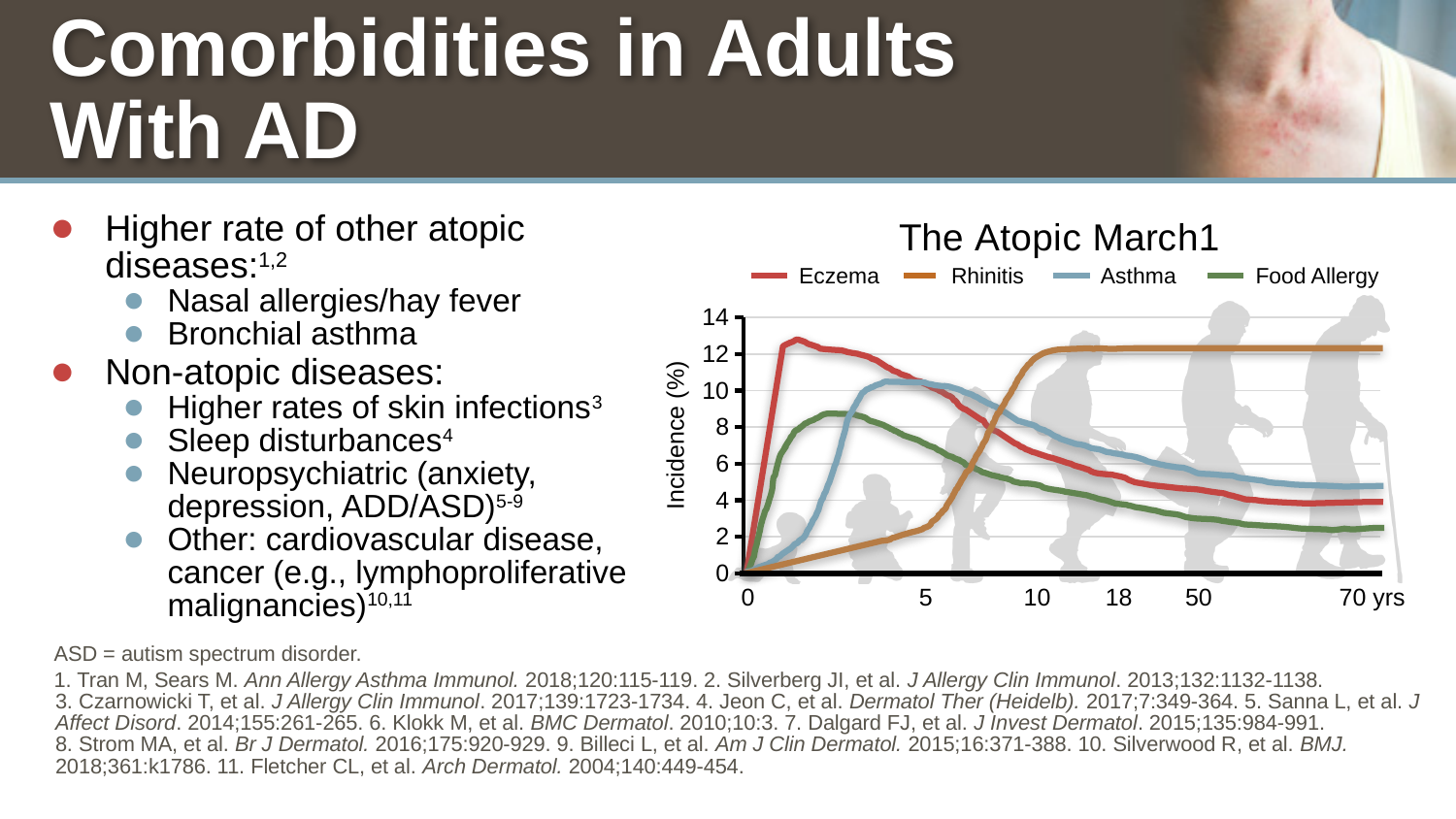
Is the value of the Asthma line at 70 yrs greater or less than 6? less At 70 yrs, which is larger, the incidence of Rhinitis or of Eczema? Rhinitis How many series does the legend of the chart list? 4 Which series has the lowest incidence at 70 yrs? Food Allergy What is the title of the chart? The Atopic March1 Is the peak value of the Eczema line greater or less than 12? greater What is the label of the y axis of the chart? Incidence (%) Does the Rhinitis line rise or fall between 0 and 10 on the x axis? rise What kind of chart is shown on the slide? line chart Which series has the highest incidence at 70 yrs? Rhinitis Is the value of the Rhinitis line at 70 yrs greater or less than 10? greater